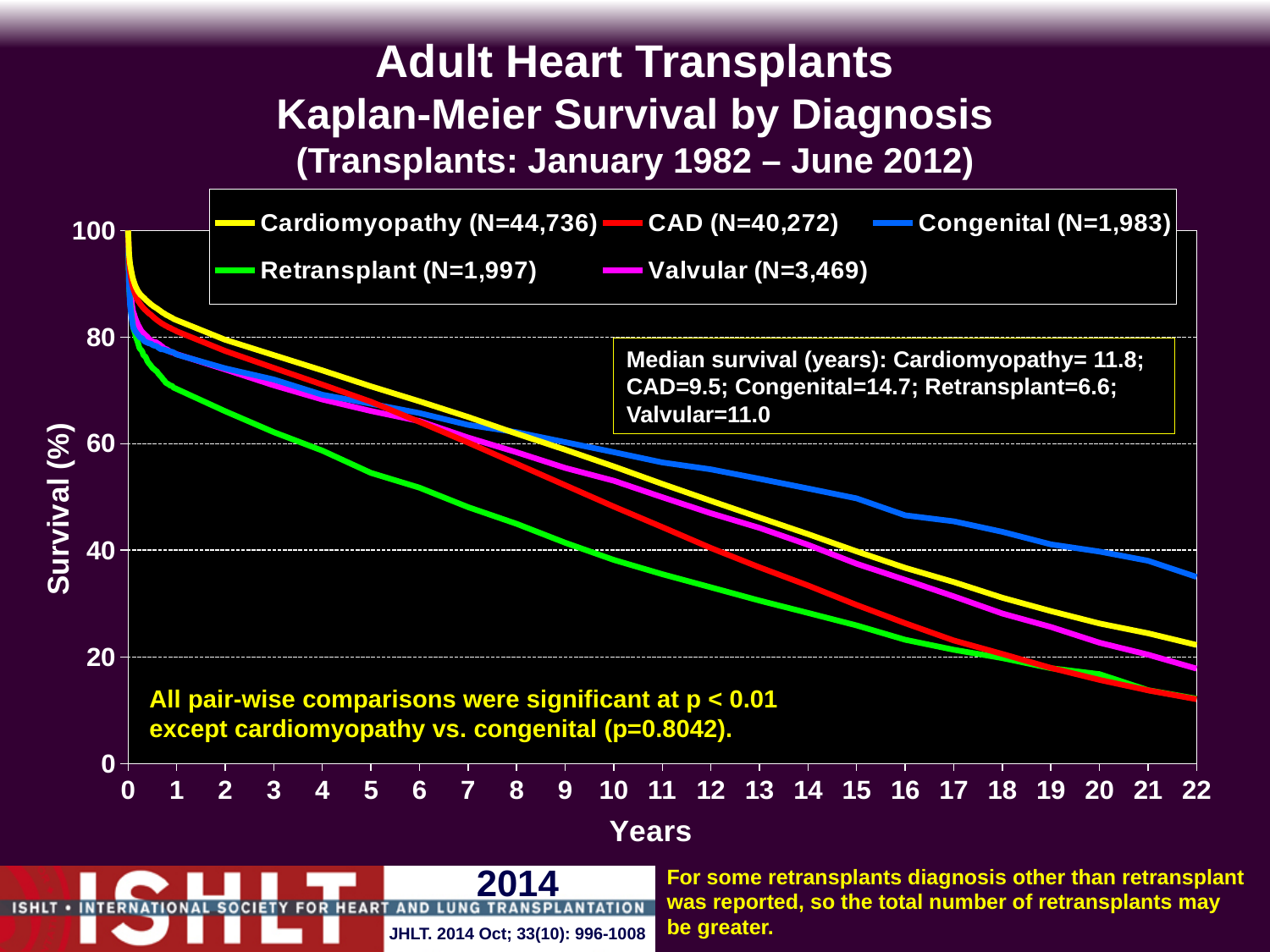
Do the survival curves rise or fall as years increase? fall What is the title of the chart? Adult Heart Transplants Kaplan-Meier Survival by Diagnosis (Transplants: January 1982 – June 2012) What kind of chart is shown on the slide? line chart What is the median survival in years for the Congenital group? 14.7 Which diagnosis group has the highest median survival? Congenital Is the Cardiomyopathy survival at 1 year greater or less than 80? greater Is the Congenital survival at 22 years greater or less than 20? greater What is the difference in median survival (years) between Cardiomyopathy and CAD? 2.3 At 20 years, which group has higher survival, Congenital or CAD? Congenital Is the Retransplant survival at 5 years greater or less than 60? less Which diagnosis group has the lowest median survival? Retransplant How many series does the legend list? 5